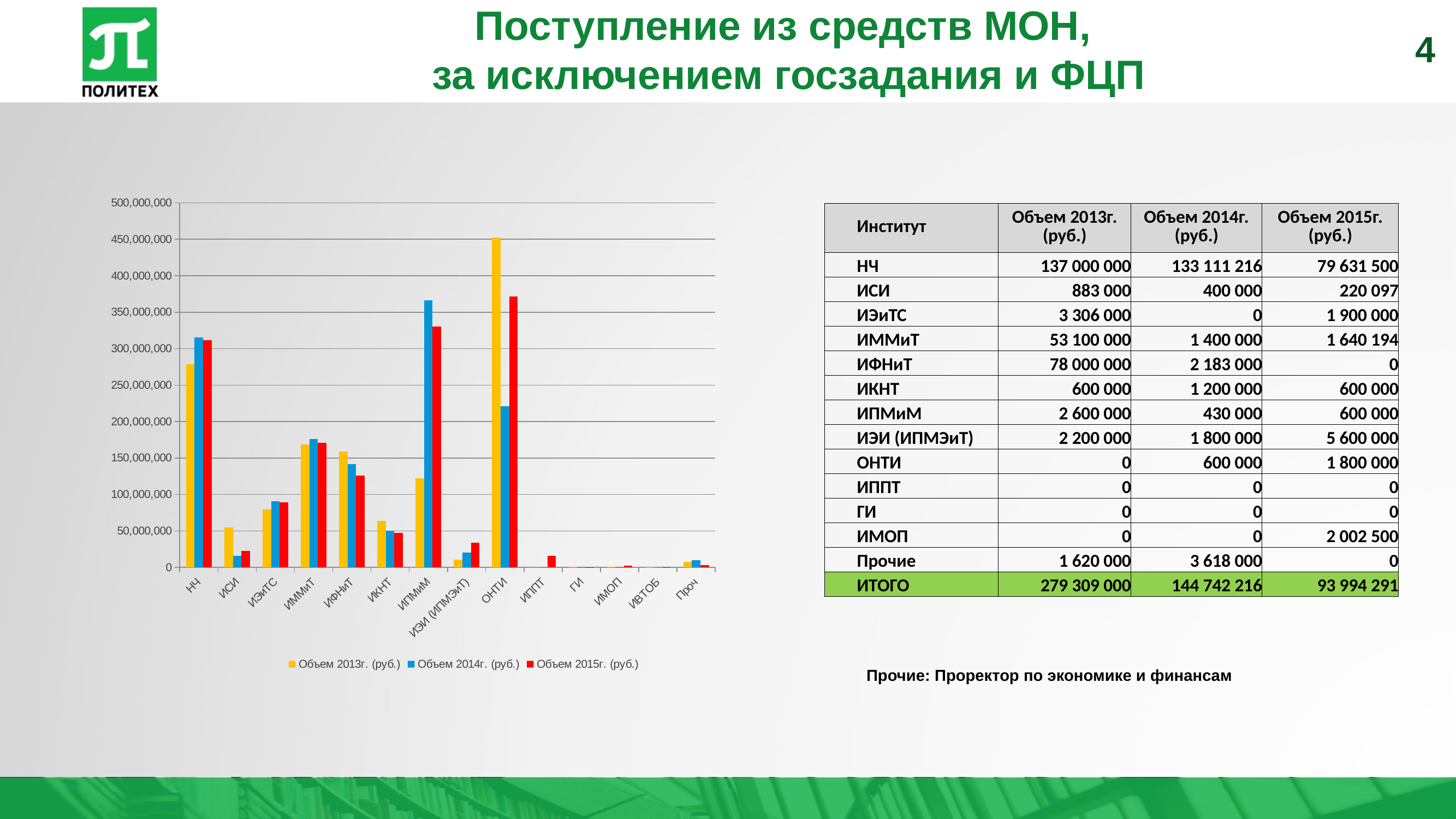
For the series Объем 2014г. (руб.), which is larger: ОНТИ or ИПМиМ? ИПМиМ What kind of chart is shown on the slide? bar chart Is the value for НЧ in the series Объем 2013г. (руб.) greater or less than 250,000,000? greater Which category has the highest value for the series Объем 2013г. (руб.)? ОНТИ Which colour represents the series Объем 2015г. (руб.) in the chart? red Which category has the highest value for the series Объем 2014г. (руб.)? ИПМиМ For the series Объем 2013г. (руб.), which is larger: НЧ or ИММиТ? НЧ Which category has the highest value for the series Объем 2015г. (руб.)? ОНТИ How many series does the chart legend list? 3 Is the value for ИФНиТ in the series Объем 2015г. (руб.) greater or less than 100,000,000? greater How many categories are shown along the x axis of the chart? 14 Is the value for ОНТИ in the series Объем 2013г. (руб.) greater or less than 400,000,000? greater